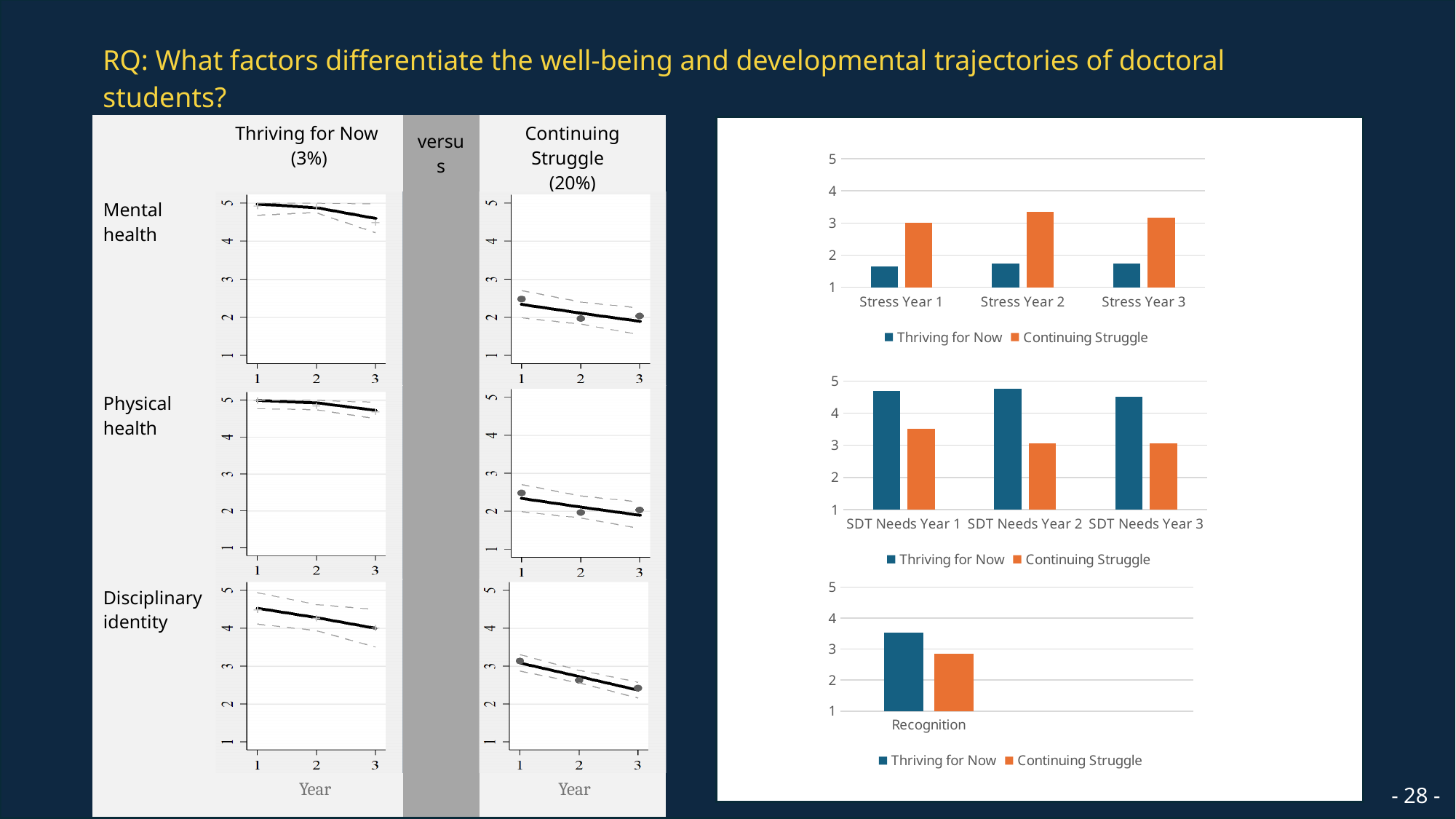
In the middle right bar chart (SDT Needs), is the value for Thriving for Now at SDT Needs Year 1 greater or less than 4? greater How many series does the legend of the top right bar chart (Stress) list? 2 In the top right bar chart (Stress), is the value for Continuing Struggle at Stress Year 2 greater or less than 3? greater In the middle right bar chart (SDT Needs), which series has the larger value at SDT Needs Year 3, Thriving for Now or Continuing Struggle? Thriving for Now In the bottom right bar chart (Recognition), is the value for Thriving for Now greater or less than 3? greater In the left panel, does the Continuing Struggle line for Mental health rise or fall from Year 1 to Year 3? fall How many categories are shown on the x axis of the middle right bar chart (SDT Needs)? 3 What kind of chart is the top chart on the right (Stress Year 1 to Stress Year 3)? bar chart In the top right bar chart (Stress), which series has the larger value at Stress Year 1, Thriving for Now or Continuing Struggle? Continuing Struggle In the bottom right bar chart (Recognition), which series has the larger value, Thriving for Now or Continuing Struggle? Thriving for Now In the right-hand bar charts, which series is shown in orange? Continuing Struggle